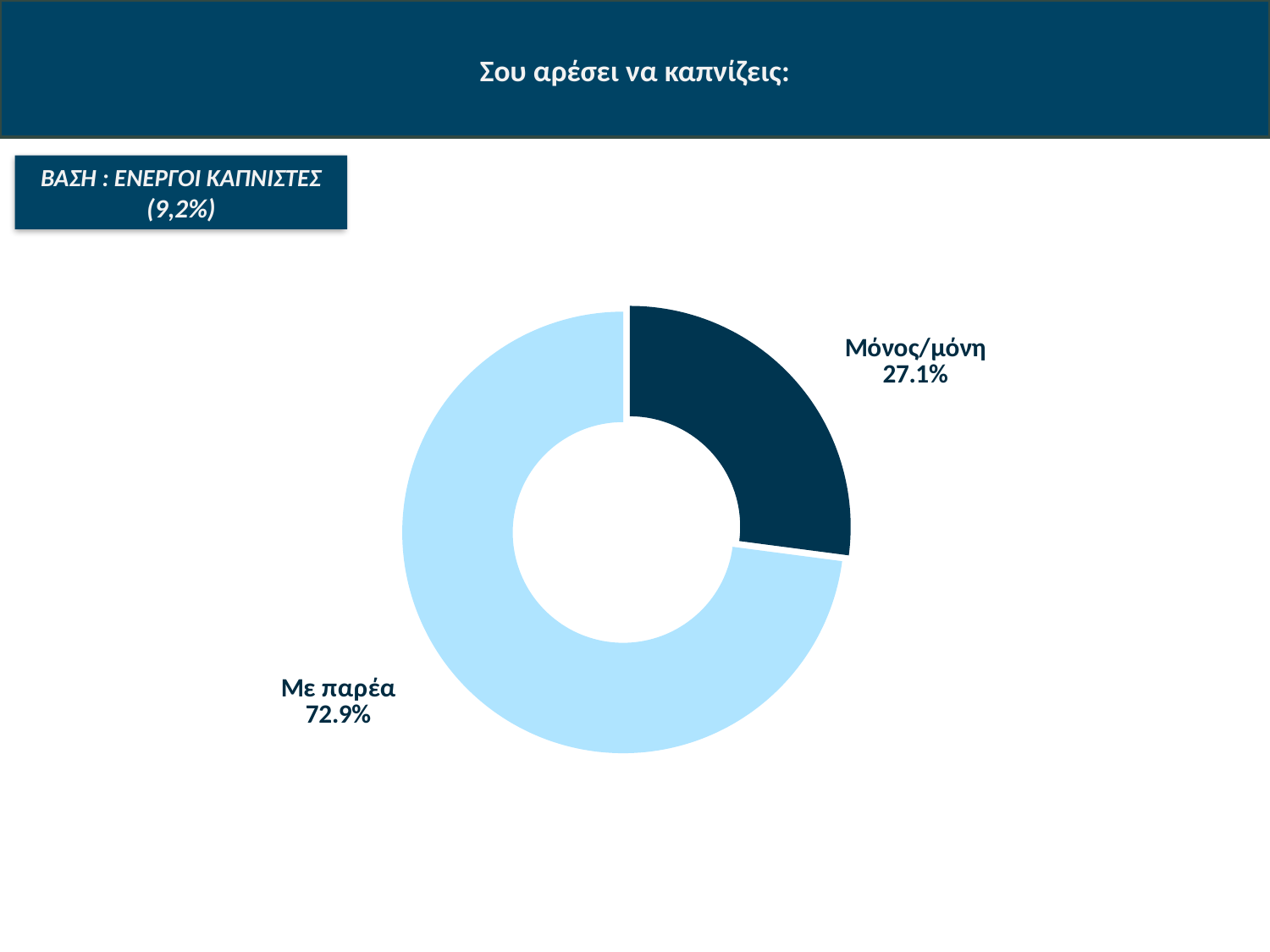
Which category has the smallest share of the chart? Μόνος/μόνη What is the total of the two percentages shown in the chart? 100% What is the difference in percentage points between Με παρέα and Μόνος/μόνη? 45.8 What percentage is shown for Με παρέα? 72.9% How many categories are shown in the chart? 2 Which is larger, the share for Μόνος/μόνη or the share for Με παρέα? Με παρέα What kind of chart is shown on the slide? Doughnut (pie) chart What percentage is shown for Μόνος/μόνη? 27.1% What base is stated for the chart in the box at the top left? ΒΑΣΗ : ΕΝΕΡΓΟΙ ΚΑΠΝΙΣΤΕΣ (9,2%) Which category has the largest share of the chart? Με παρέα What is the title of the slide? Σου αρέσει να καπνίζεις: